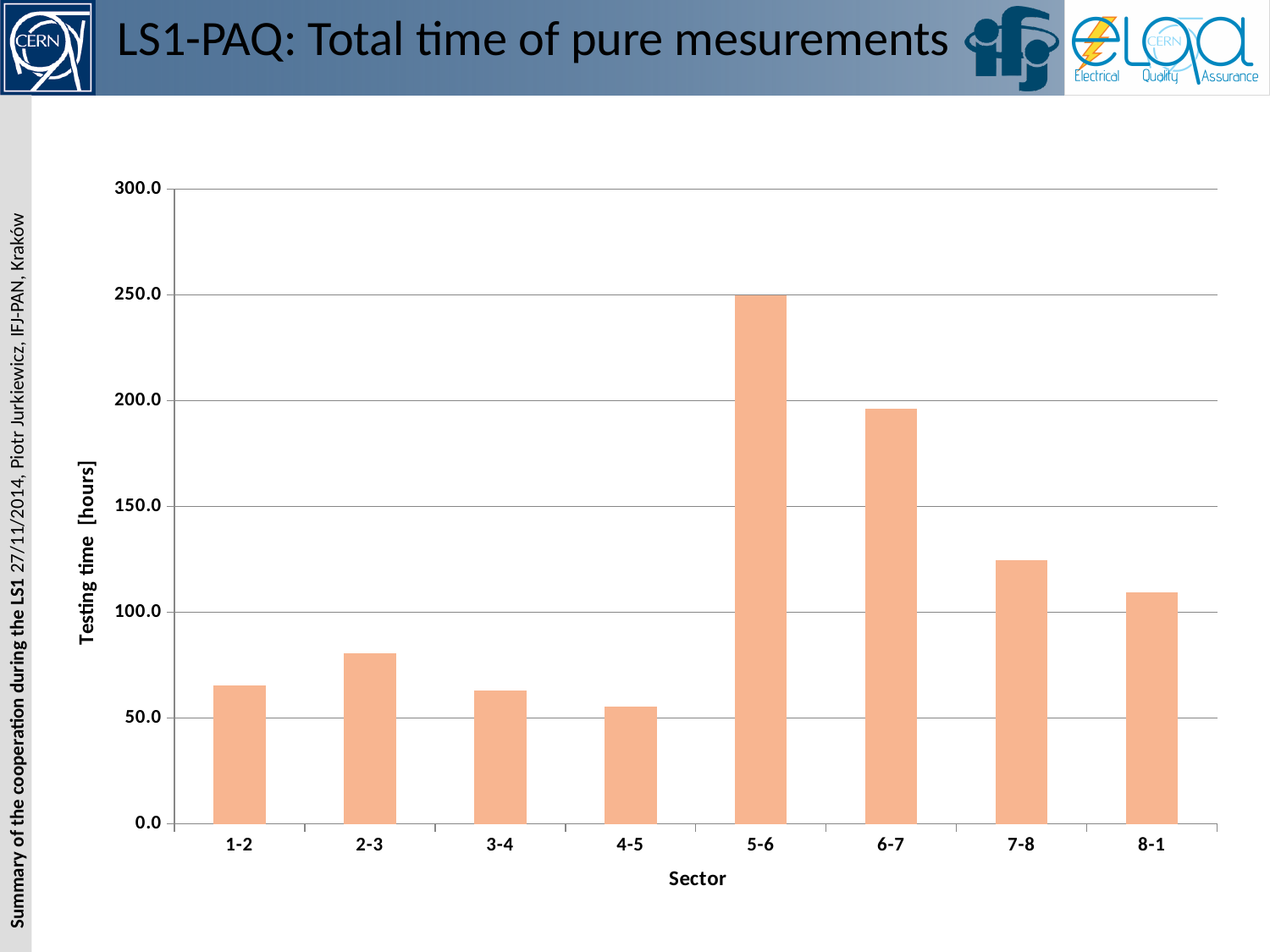
Is the testing time for sector 7-8 greater or less than 100.0 hours? greater Is the testing time for sector 2-3 greater or less than 100.0 hours? less What is the label of the x axis of the chart? Sector Which sector has a larger testing time, 6-7 or 7-8? 6-7 Which sector has a larger testing time, 2-3 or 4-5? 2-3 What kind of chart is shown on the slide? bar chart Which sector has the highest testing time? 5-6 Is the testing time for sector 6-7 greater or less than 150.0 hours? greater How many sectors are shown on the x axis of the chart? 8 Which sector has the lowest testing time? 4-5